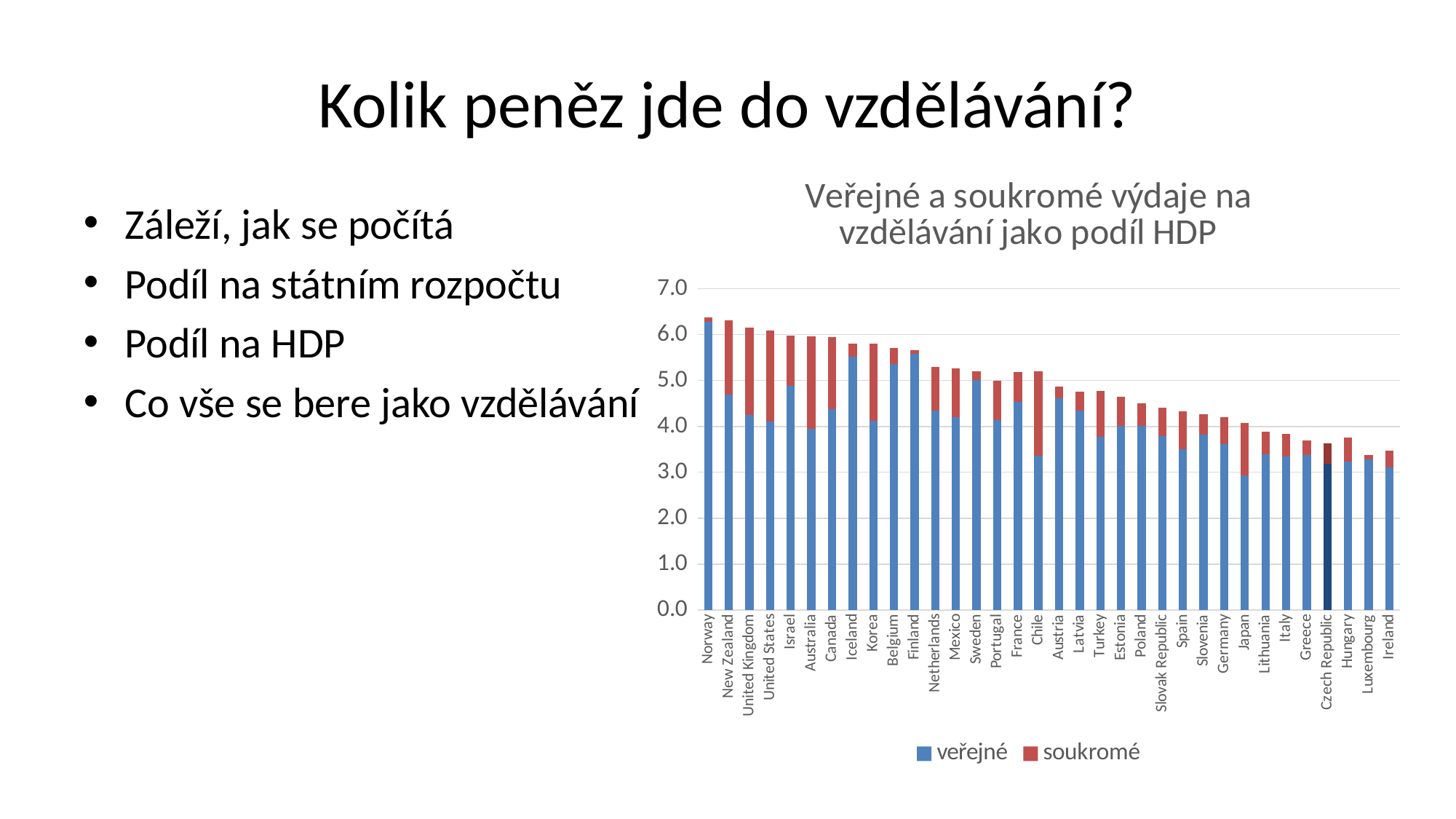
What kind of chart is shown on the slide? stacked bar chart How many countries are shown on the x axis of the chart? 34 Is the veřejné value for Chile greater or less than 4.0? less Is the total value for Ireland greater or less than 4.0? less What is the title of the chart? Veřejné a soukromé výdaje na vzdělávání jako podíl HDP Which has the larger veřejné value, Finland or Chile? Finland How many series does the chart legend list? 2 Which has the larger soukromé value, Chile or Finland? Chile Is the total value for Norway greater or less than 6.0? greater Do the total bar heights generally rise or fall from left to right along the x axis? fall